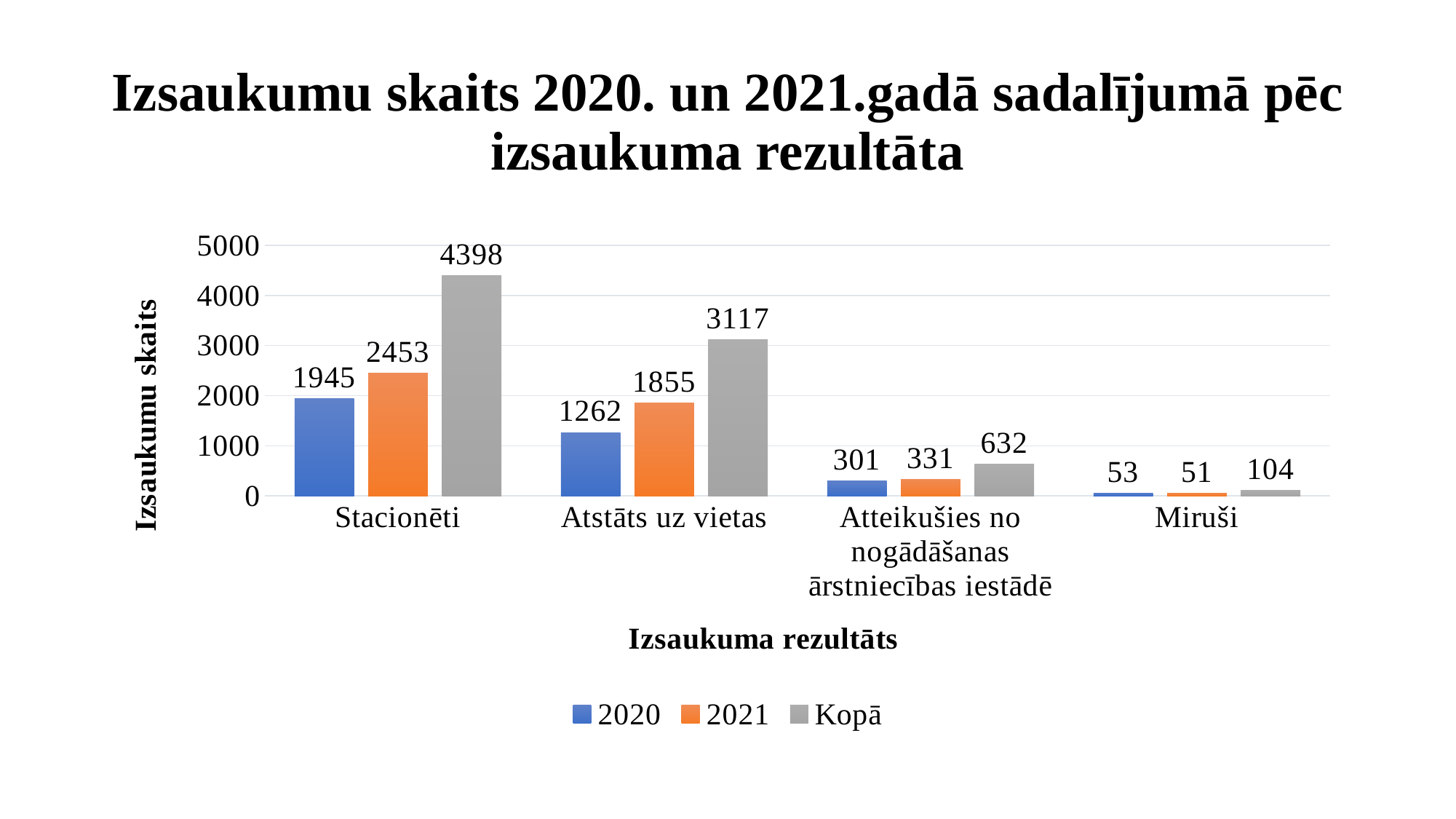
Which category has the lowest 2020 value? Miruši What is the label of the y axis? Izsaukumu skaits Which is larger for Atstāts uz vietas: the 2020 value or the 2021 value? 2021 How many series does the legend list? 3 What is the Kopā value for Atstāts uz vietas? 3117 What is the difference between the 2021 and 2020 values for Stacionēti? 508 What is the value for 2020 in the Stacionēti category? 1945 How many categories are shown on the x axis? 4 Which category has the highest Kopā value? Stacionēti What kind of chart is shown on the slide? bar chart What is the 2021 value for Miruši? 51 Is the Kopā value for Atteikušies no nogādāšanas ārstniecības iestādē greater or less than 1000? less